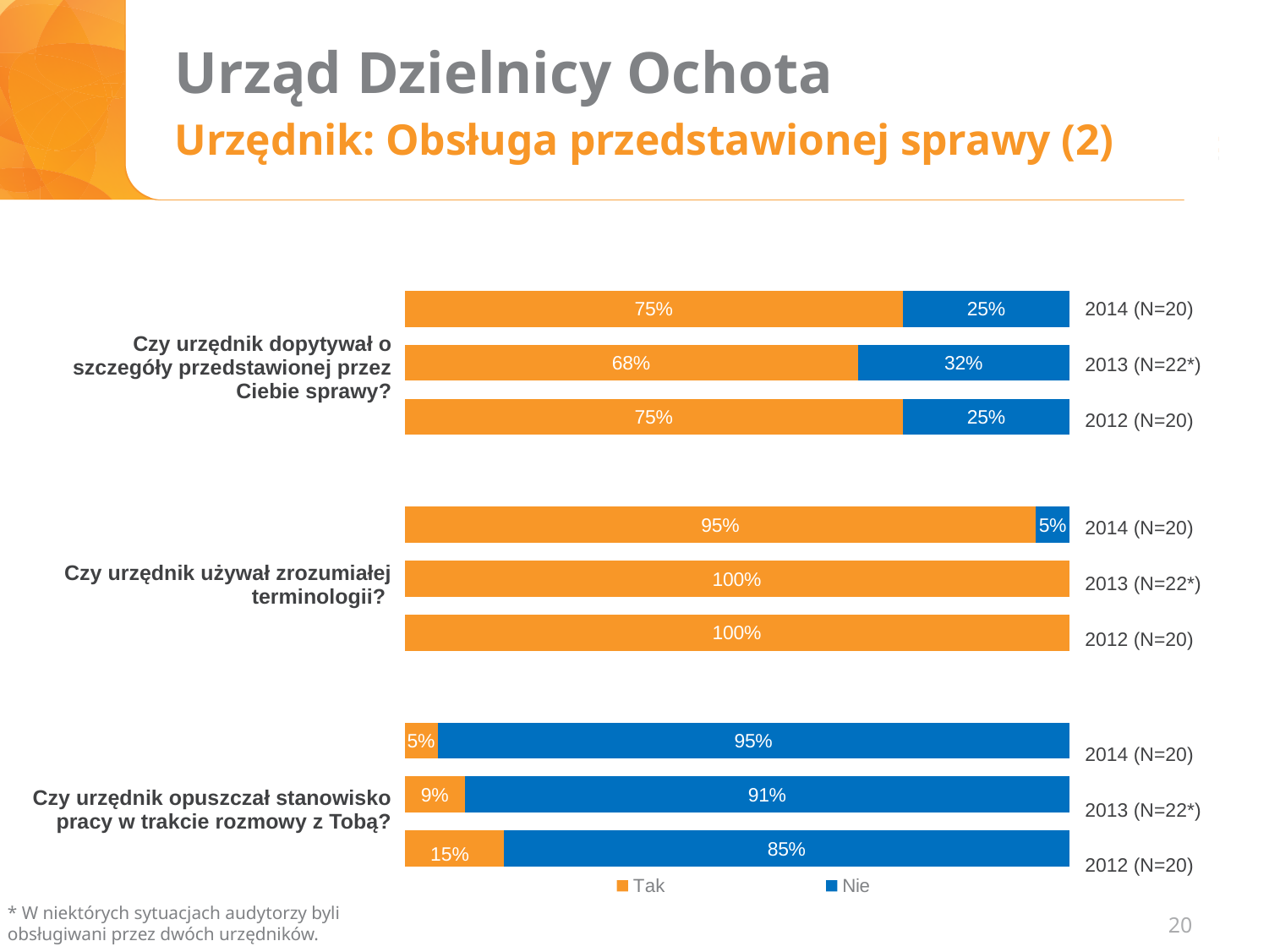
For the question "Czy urzędnik dopytywał o szczegóły przedstawionej przez Ciebie sprawy?", what percentage answered "Tak" in 2014 (N=20)? 75% For the question "Czy urzędnik dopytywał o szczegóły przedstawionej przez Ciebie sprawy?", which year has the lowest "Tak" share? 2013 (N=22*) What kind of chart is used on the slide? Stacked bar chart Which colour represents "Nie" in the legend? Blue For the question "Czy urzędnik używał zrozumiałej terminologii?", what percentage answered "Nie" in 2014 (N=20)? 5% For the question "Czy urzędnik opuszczał stanowisko pracy w trakcie rozmowy z Tobą?", does the "Tak" share rise or fall from 2012 to 2014? Fall For the question "Czy urzędnik opuszczał stanowisko pracy w trakcie rozmowy z Tobą?", which year has the highest "Nie" share? 2014 (N=20) For the question "Czy urzędnik opuszczał stanowisko pracy w trakcie rozmowy z Tobą?", what percentage answered "Tak" in 2012 (N=20)? 15% How many series does the legend list? 2 For the question "Czy urzędnik dopytywał o szczegóły przedstawionej przez Ciebie sprawy?", what percentage answered "Nie" in 2013 (N=22*)? 32% For the question "Czy urzędnik dopytywał o szczegóły przedstawionej przez Ciebie sprawy?", is the "Tak" share larger in 2014 (N=20) or in 2013 (N=22*)? 2014 (N=20) For the question "Czy urzędnik opuszczał stanowisko pracy w trakcie rozmowy z Tobą?", what is the difference between the "Nie" share in 2014 (N=20) and in 2012 (N=20)? 10 percentage points